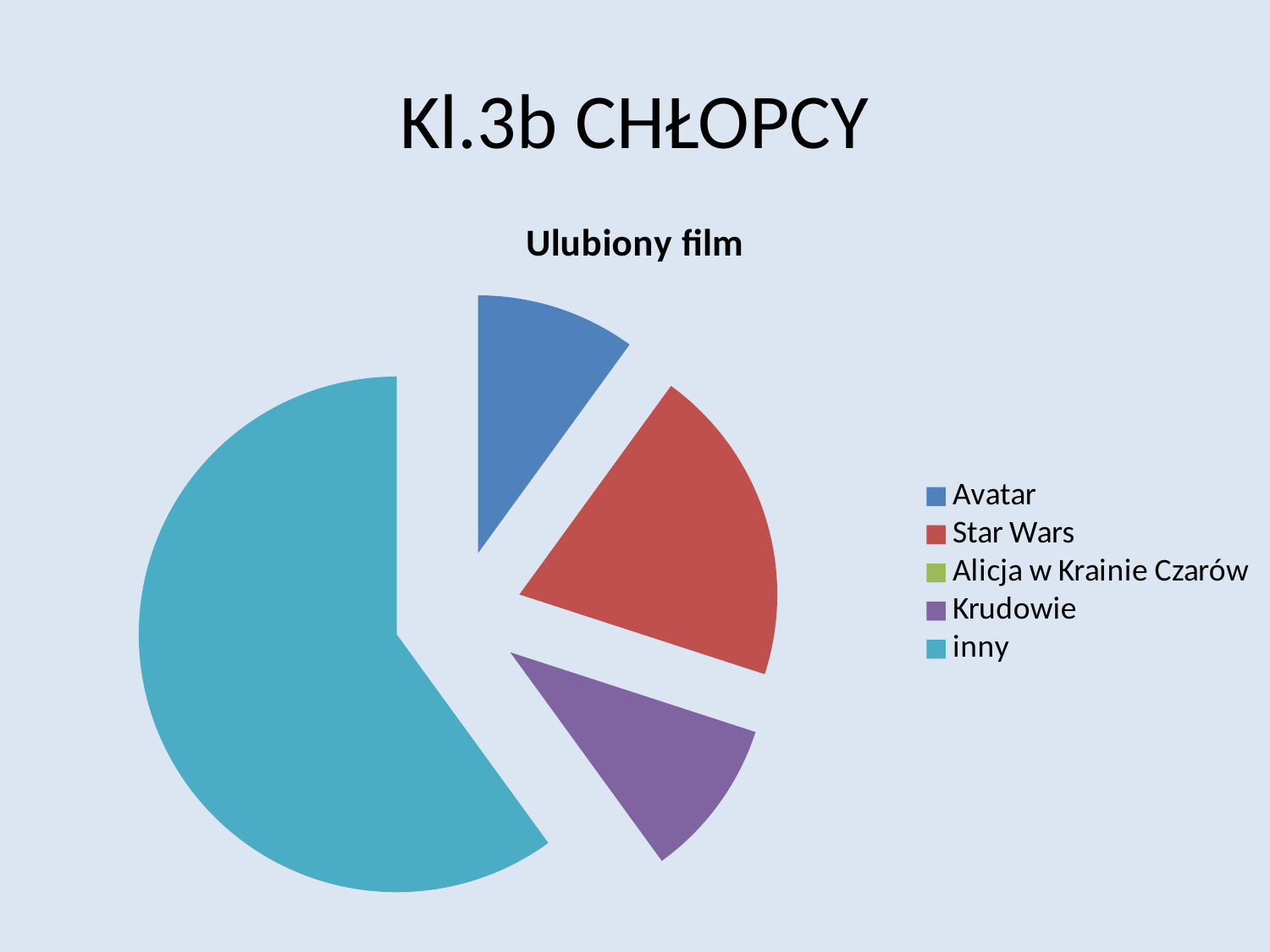
Which slice is larger, Star Wars or Krudowie? Star Wars What colour is the slice for inny? teal Which category has the largest slice of the pie? inny Which legend entry is listed first? Avatar Which slice is larger, inny or Star Wars? inny Which slice is larger, Star Wars or Avatar? Star Wars How many categories does the chart's legend list? 5 What is the title of the chart? Ulubiony film What kind of chart is shown on the slide? pie chart